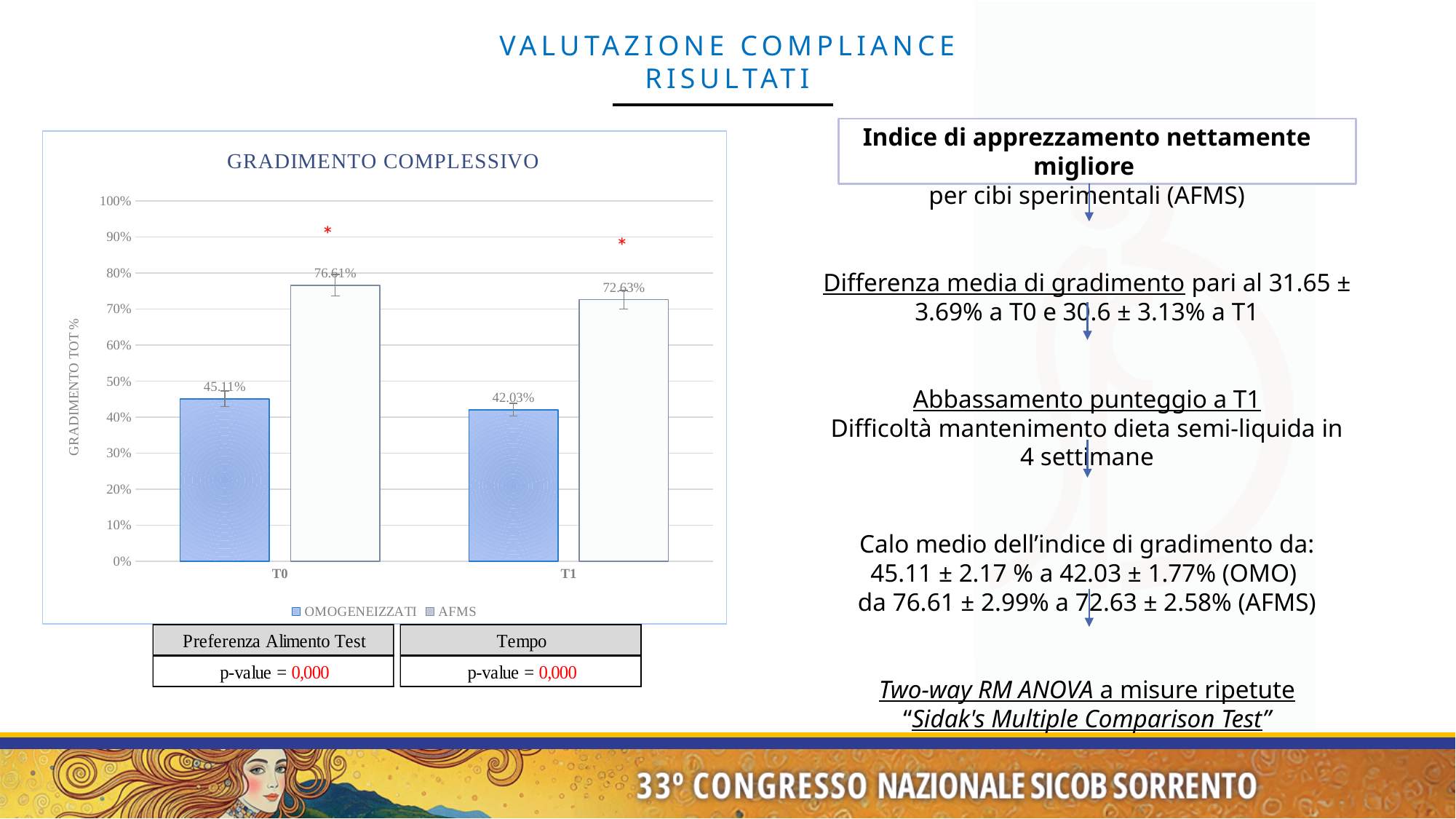
Which bar has the highest value in the GRADIMENTO COMPLESSIVO chart? AFMS at T0 In the GRADIMENTO COMPLESSIVO chart, which is larger: OMOGENEIZZATI at T0 or OMOGENEIZZATI at T1? OMOGENEIZZATI at T0 What is the difference between the AFMS and OMOGENEIZZATI values at T0 in the GRADIMENTO COMPLESSIVO chart? 31.50% Do the AFMS values rise or fall from T0 to T1 in the GRADIMENTO COMPLESSIVO chart? fall What is the value for AFMS at T1 in the GRADIMENTO COMPLESSIVO chart? 72.63% What is the value for AFMS at T0 in the GRADIMENTO COMPLESSIVO chart? 76.61% What is the value for OMOGENEIZZATI at T0 in the GRADIMENTO COMPLESSIVO chart? 45.11% What type of chart is shown under the title GRADIMENTO COMPLESSIVO? bar chart Which bar has the lowest value in the GRADIMENTO COMPLESSIVO chart? OMOGENEIZZATI at T1 How many series does the legend of the GRADIMENTO COMPLESSIVO chart list? 2 What is the value for OMOGENEIZZATI at T1 in the GRADIMENTO COMPLESSIVO chart? 42.03% What is the difference between the AFMS values at T0 and T1 in the GRADIMENTO COMPLESSIVO chart? 3.98%